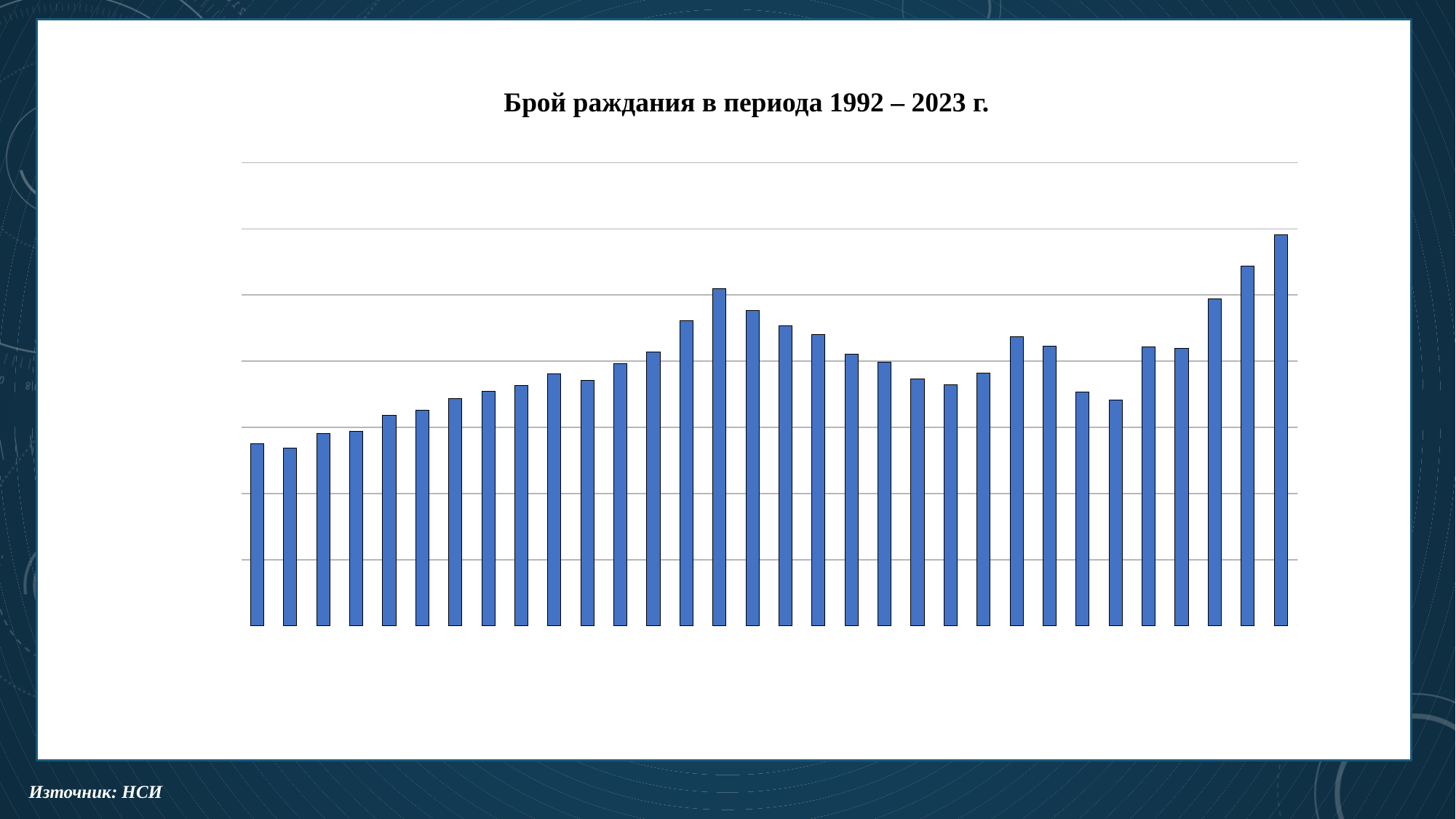
Is the rightmost bar taller or shorter than the leftmost bar? taller Does the chart show data labels on the bars? no What is the title of the chart? Брой раждания в периода 1992 – 2023 г. Which bar is the tallest in the chart, by position? the rightmost (last) bar What colour are the bars in the chart? blue How many bars are plotted in the chart? 32 Is the tallest bar in the middle of the chart (the peak around the 15th bar) taller or shorter than the rightmost bar? shorter Do the bars generally rise or fall across the first half of the chart, from the leftmost bar to the peak near the middle? rise How many data series are plotted in the chart? 1 What kind of chart is shown on the slide? bar chart